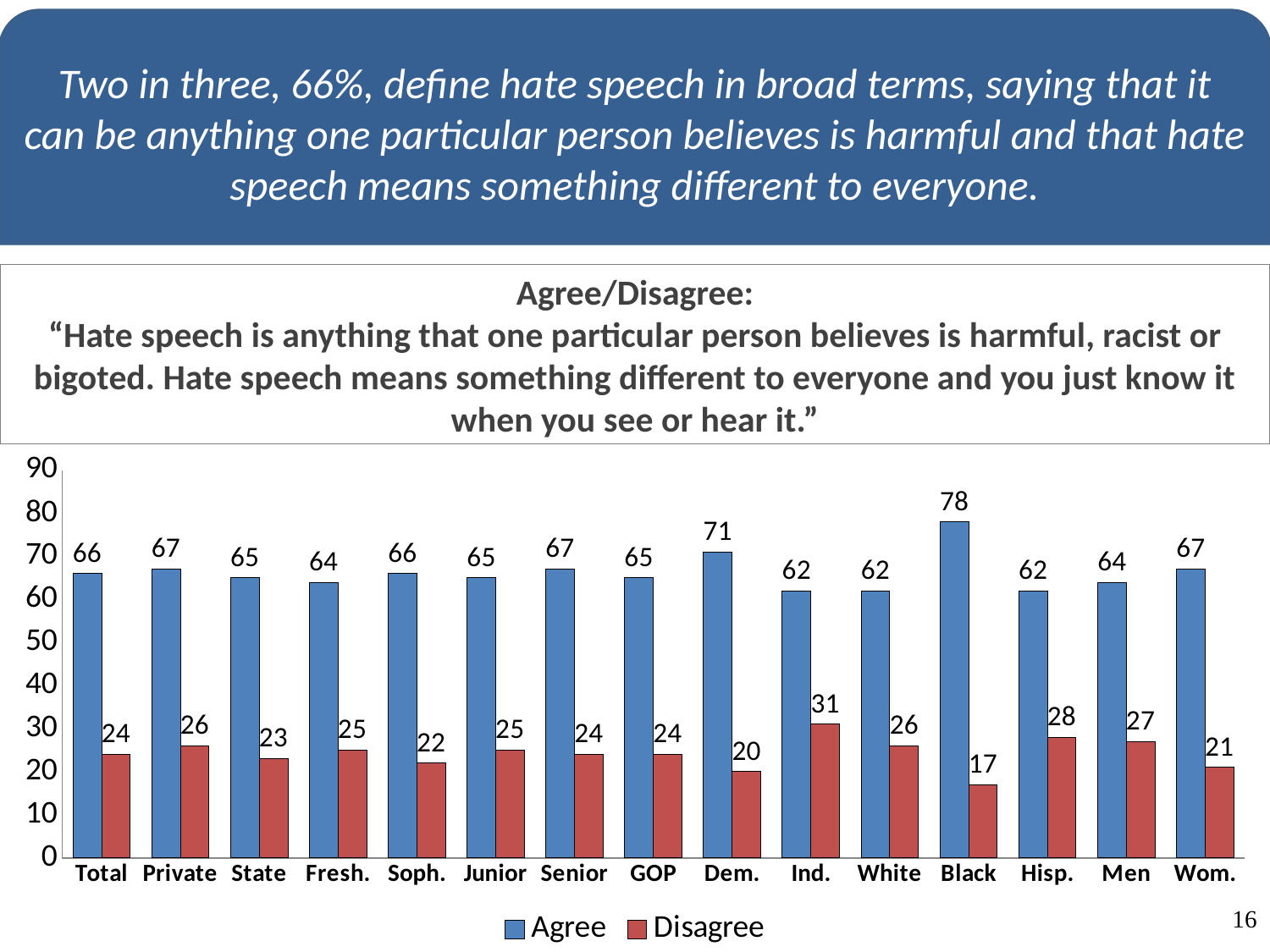
Which category has the lowest Disagree value? Black Which is larger, the Disagree value for Ind. or the Disagree value for Wom.? Ind. Which category has the highest Agree value? Black What is the Disagree value for Ind.? 31 What kind of chart is shown on the slide? bar chart How many categories are shown on the x axis? 15 How many series does the legend list? 2 What is the difference between the Agree and Disagree values for Dem.? 51 What is the Agree value for Total? 66 Is the Agree value for Hisp. greater or less than 70? less What colour are the Disagree bars? red What is the Agree value for Black? 78